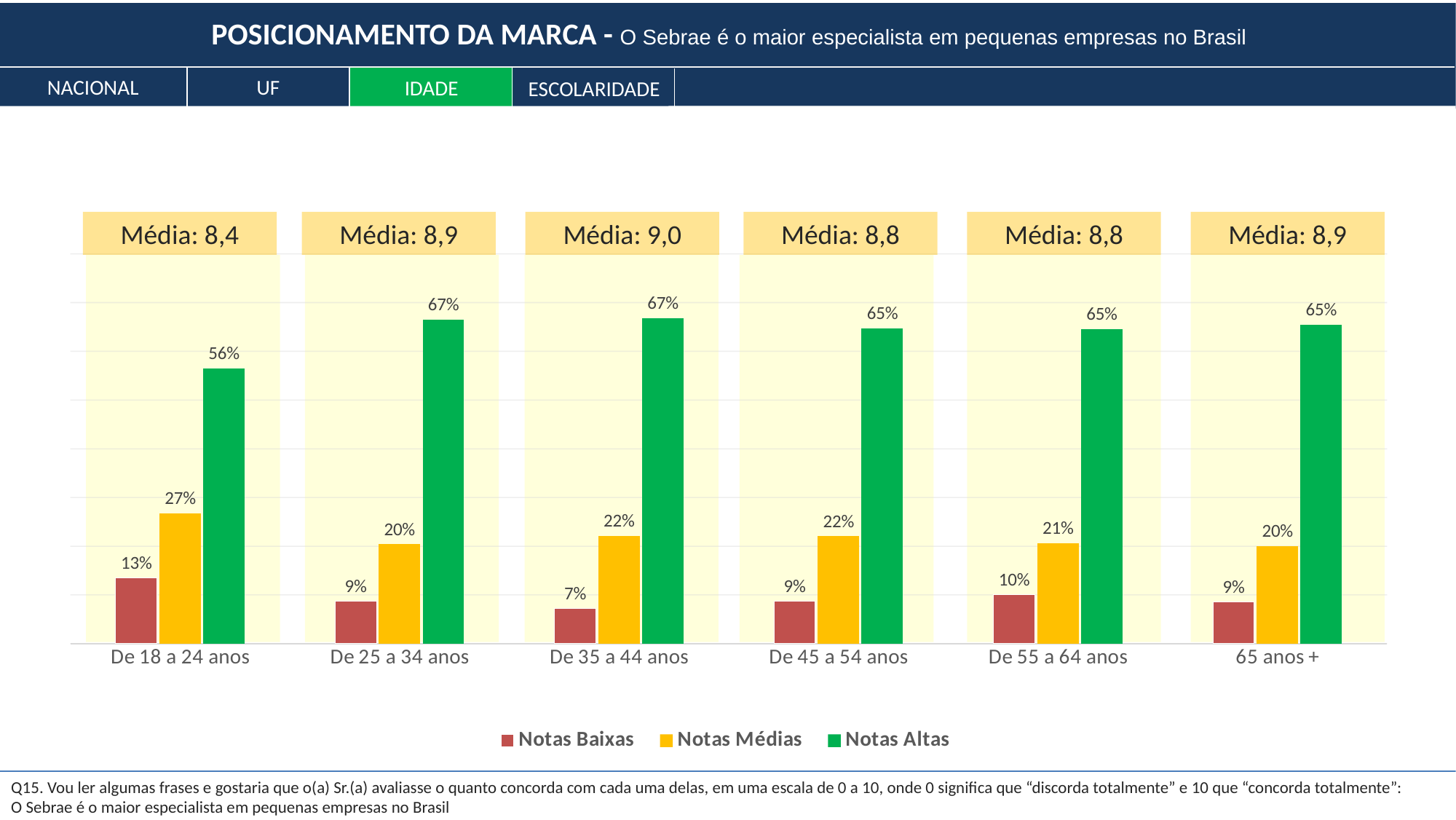
Which colour represents Notas Altas in the legend? Green Which is larger: Notas Baixas for De 18 a 24 anos or Notas Baixas for De 55 a 64 anos? De 18 a 24 anos Which age group has the lowest Notas Baixas value? De 35 a 44 anos How many age groups are shown on the x axis? 6 What is the value of Notas Médias for De 55 a 64 anos? 21% What is the Média shown above the De 35 a 44 anos group? 9,0 How many series does the legend list? 3 What is the value of Notas Baixas for De 35 a 44 anos? 7% Which age group has the highest Notas Médias value? De 18 a 24 anos What is the value of Notas Altas for De 18 a 24 anos? 56% What is the difference between Notas Altas for De 25 a 34 anos and De 18 a 24 anos? 11% What kind of chart is shown on the slide? Bar chart